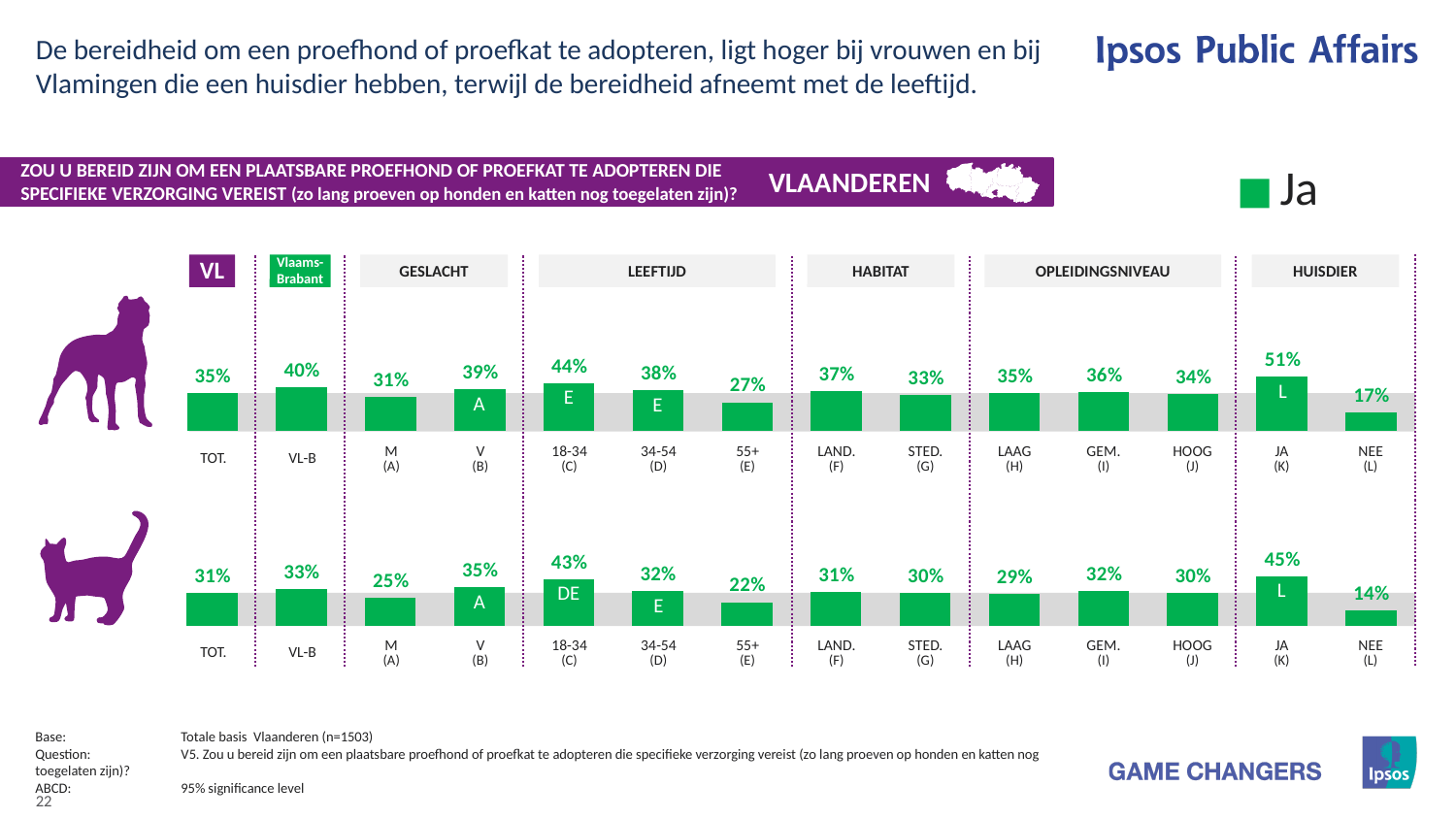
How many categories are plotted in the bottom row (cat) chart? 14 In the bottom row (cat) chart, what is the difference between the values for JA (K) and NEE (L)? 31% In the top row (dog) chart, what is the difference between the values for V (B) and M (A)? 8% In the top row (dog) chart, which category has the highest value? JA (K) In the top row (dog) chart, what is the value for TOT.? 35% What kind of chart is used on this slide? bar chart What is the single legend entry shown on the slide? Ja In the top row (dog) chart, what is the value for Vlaams-Brabant (VL-B)? 40% In the bottom row (cat) chart, which is larger, the value for 18-34 or the value for 34-54? 18-34 In the top row (dog) chart, do the values rise or fall across the age groups from 18-34 to 55+? fall In the bottom row (cat) chart, what is the value for the 55+ age group? 22% In the bottom row (cat) chart, which category has the lowest value? NEE (L)